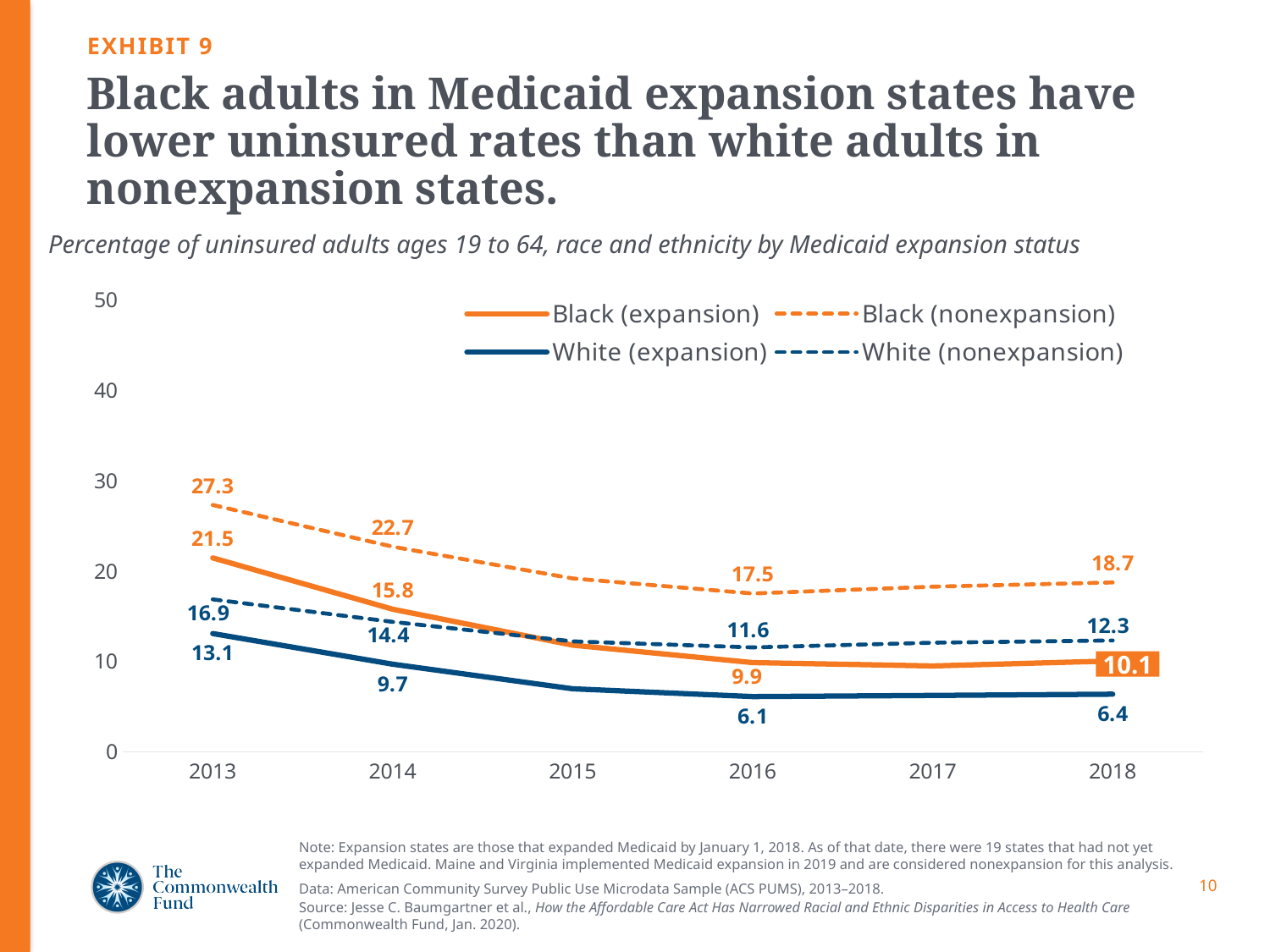
In 2018, which was higher: Black (expansion) or White (nonexpansion)? White (nonexpansion) Is the value for White (expansion) in 2015 greater or less than 10? less Which series had the highest uninsured rate in 2013? Black (nonexpansion) What was the uninsured rate for Black (nonexpansion) adults in 2013? 27.3 What was the uninsured rate for White (nonexpansion) adults in 2014? 14.4 What kind of chart is shown on the slide? Line chart What was the uninsured rate for White (expansion) adults in 2018? 6.4 How many series does the legend list? 4 In 2018, how much higher was the Black (nonexpansion) rate than the White (expansion) rate? 12.3 What was the uninsured rate for Black (expansion) adults in 2016? 9.9 Which series had the lowest uninsured rate in 2016? White (expansion) By how much did the Black (expansion) uninsured rate fall from 2013 to 2018? 11.4